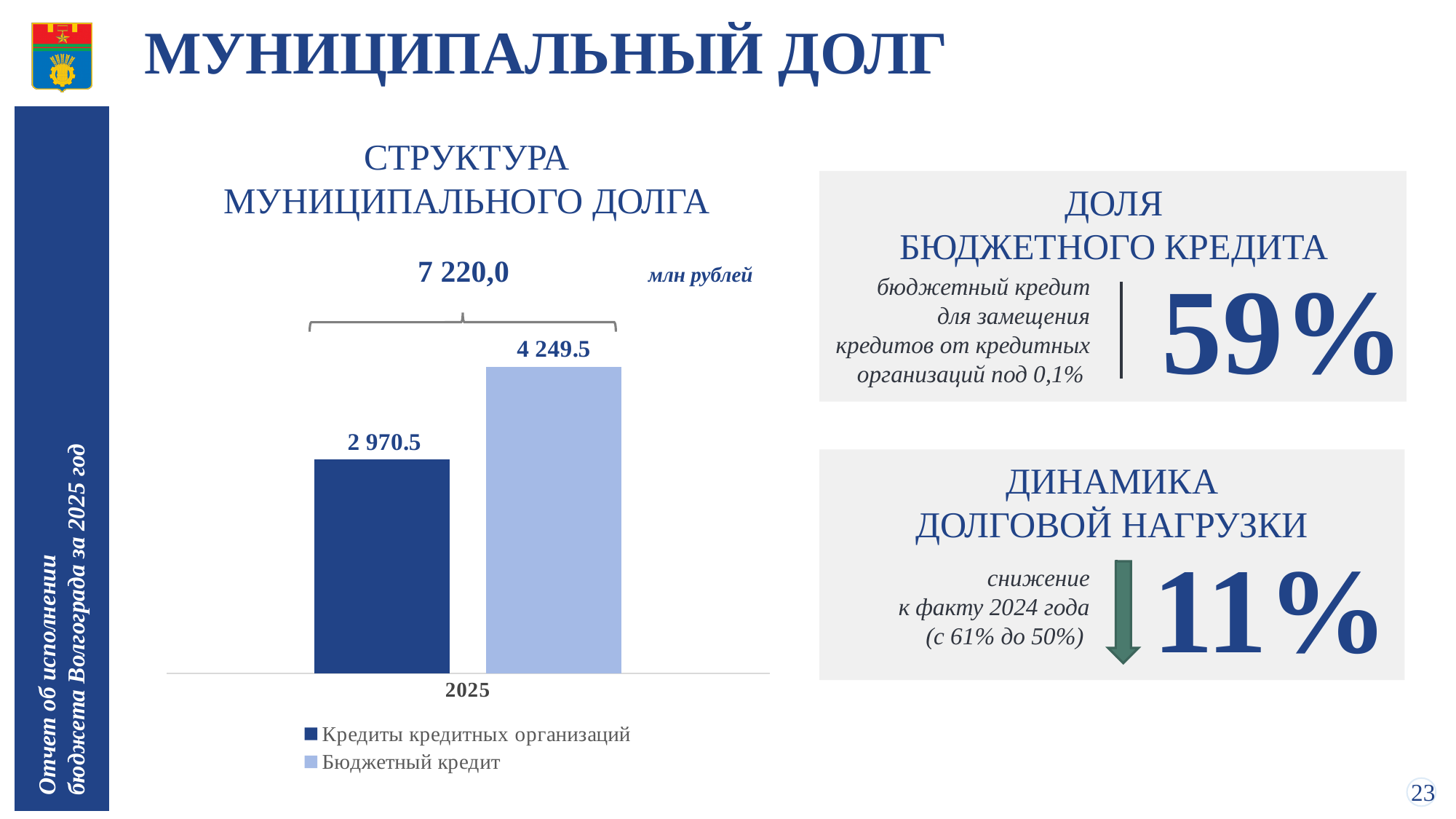
How many series does the legend list? 2 What total is shown above the bars for 2025? 7 220,0 What is the title of the chart? СТРУКТУРА МУНИЦИПАЛЬНОГО ДОЛГА Which series has the highest value in the chart? Бюджетный кредит What is the difference between the Бюджетный кредит value and the Кредиты кредитных организаций value in 2025? 1 279.0 How many categories are shown on the x axis? 1 What kind of chart is shown on the slide? bar chart Which series has the lowest value in the chart? Кредиты кредитных организаций What is the value for Бюджетный кредит in 2025? 4 249.5 What is the value for Кредиты кредитных организаций in 2025? 2 970.5 Which series has the higher value in 2025, Кредиты кредитных организаций or Бюджетный кредит? Бюджетный кредит What unit is indicated for the chart values? млн рублей